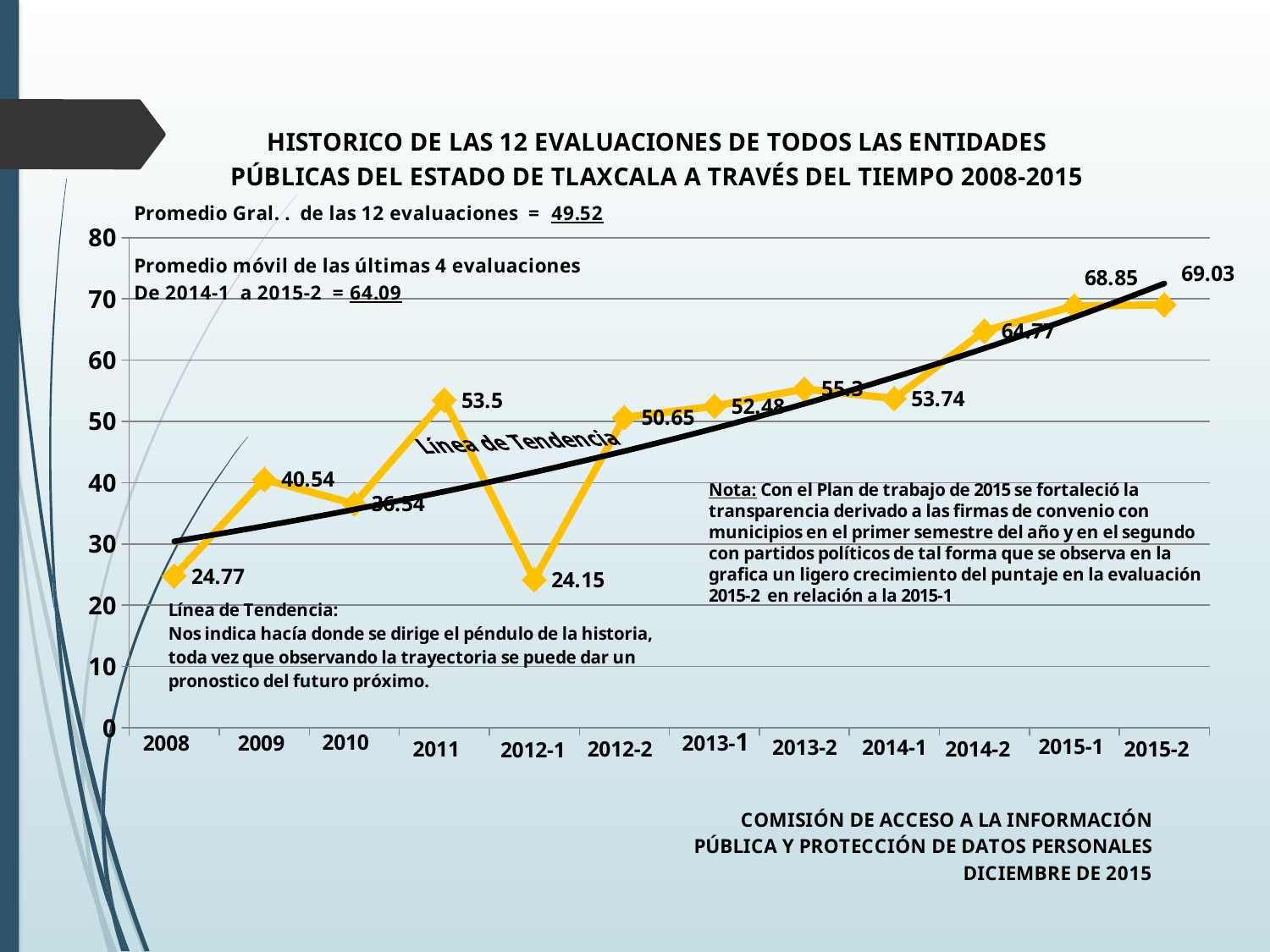
According to the text on the slide, what is the general average (Promedio Gral.) of the 12 evaluations? 49.52 What is the value plotted for 2015-2? 69.03 Which evaluation period has the lowest value? 2012-1 What kind of chart is shown on the slide? line chart Is the value for 2014-2 greater or less than 60? greater Which has the larger value, 2009 or 2010? 2009 What is the difference between the values for 2015-2 and 2008? 44.26 What is the value plotted for 2012-2? 50.65 What is the value plotted for 2011? 53.5 How many evaluation periods are plotted on the x axis? 12 What is the value plotted for 2008? 24.77 Which evaluation period has the highest value? 2015-2